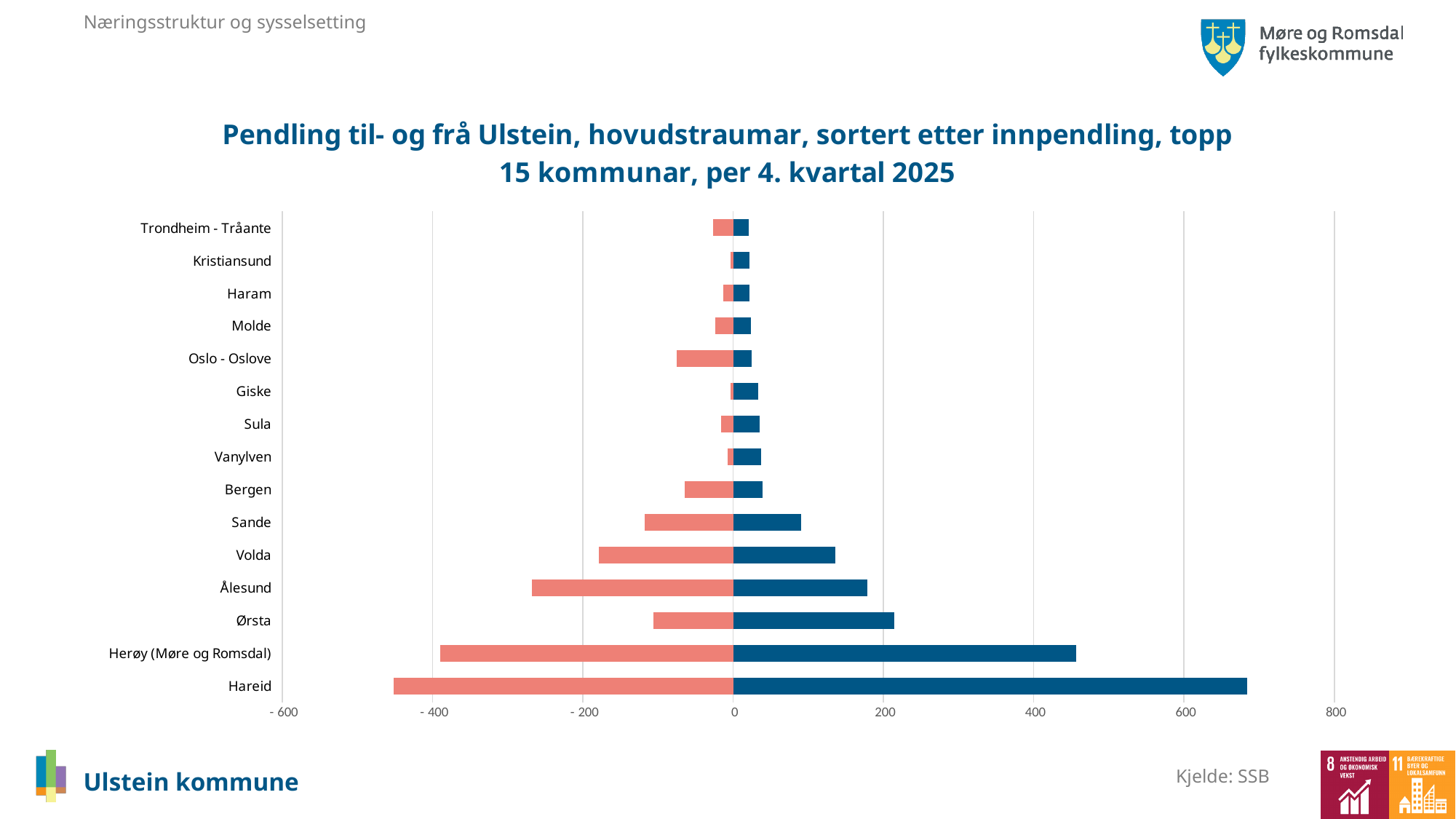
Which has the longer blue bar, Hareid or Herøy (Møre og Romsdal)? Hareid Which has the longer red bar, Ålesund or Ørsta? Ålesund Which municipality has the longest blue (positive) bar in the chart? Hareid How many municipalities (categories) are listed on the vertical axis of the chart? 15 What kind of chart is shown on the slide? bar chart What is the title of the chart? Pendling til- og frå Ulstein, hovudstraumar, sortert etter innpendling, topp 15 kommunar, per 4. kvartal 2025 Is the red bar value for Hareid greater or less than -400? less Is the blue bar value for Herøy (Møre og Romsdal) greater or less than 400? greater Is the blue bar value for Hareid greater or less than 600? greater Which municipality has the longest red (negative) bar in the chart? Hareid